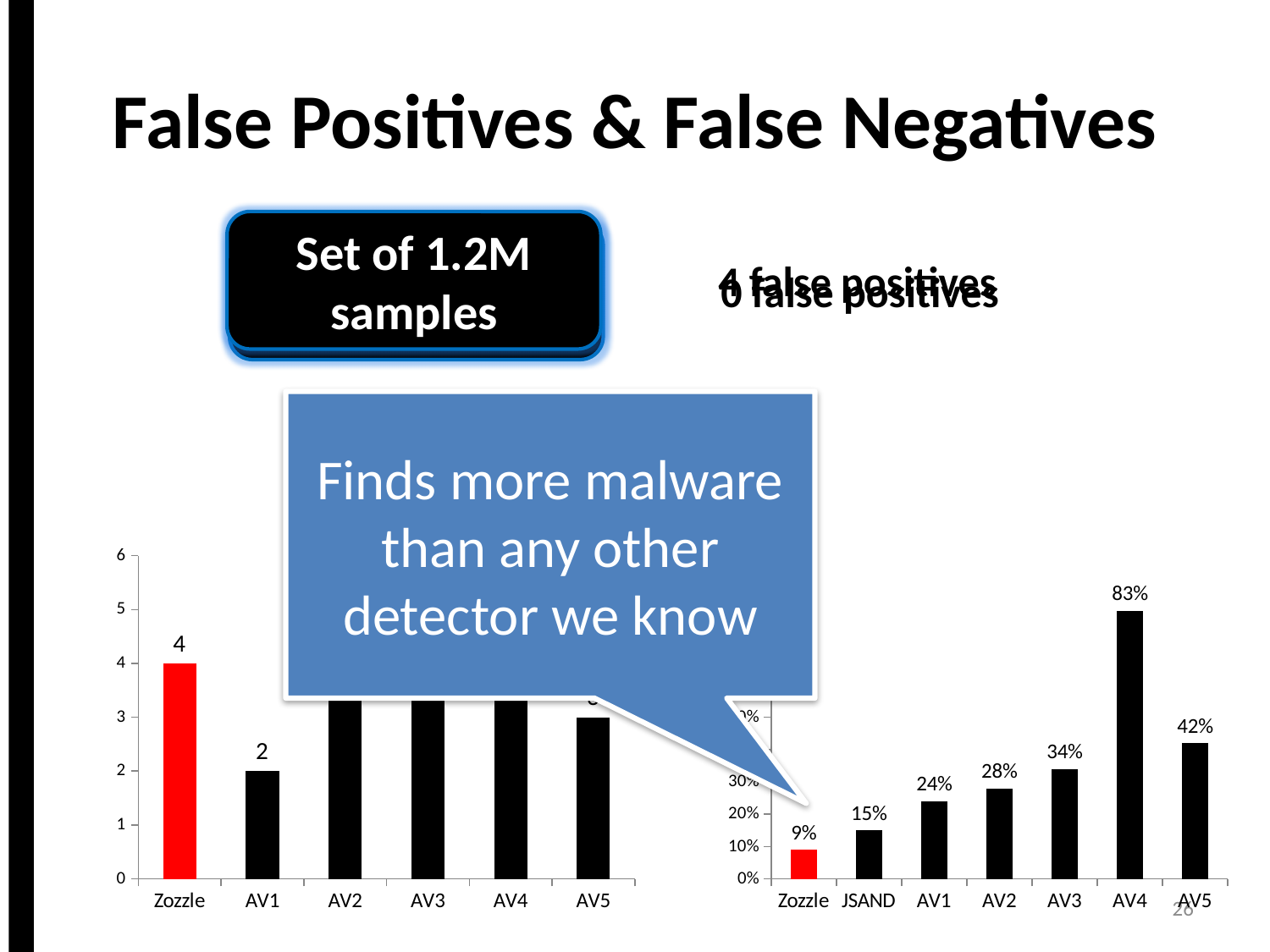
How many categories are shown on the x axis of the right chart? 7 In the right chart, what is the value for JSAND? 15% In the right chart, what is the value for Zozzle? 9% In the left chart, what is the difference between the values for Zozzle and AV1? 2 In the left chart, what is the value for AV1? 2 In the right chart, what is the difference between the values for AV5 and AV3? 8% In the left chart, what is the value for Zozzle? 4 In the right chart, which category has the lowest value? Zozzle In the left chart, which category has the lowest value? AV1 In the right chart, which category has the highest value? AV4 How many categories are shown on the x axis of the left chart? 6 In the right chart, what is the value for AV4? 83%